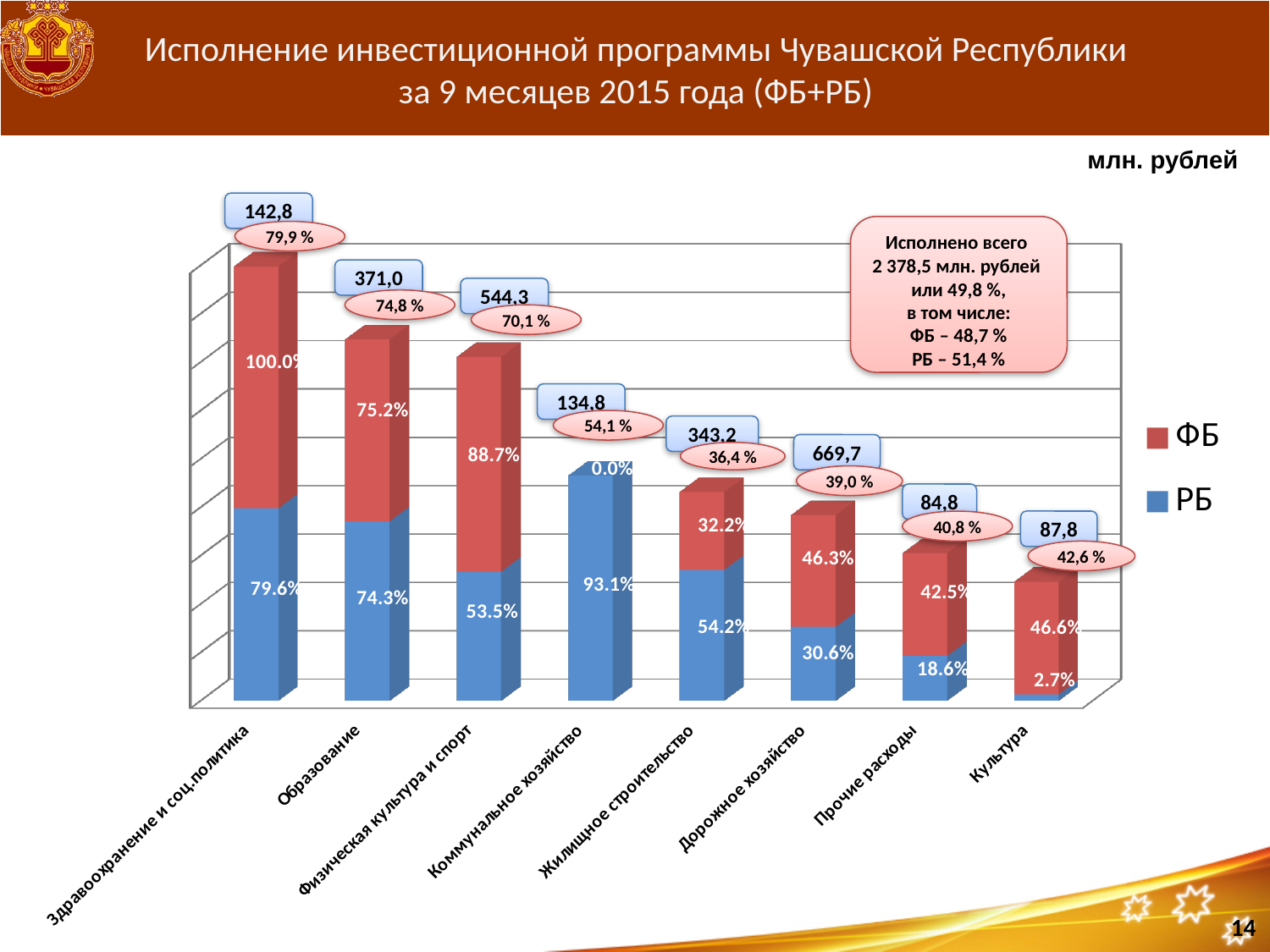
Which category has the lowest amount in млн. рублей shown in its callout? Прочие расходы What is the ФБ value labelled for Коммунальное хозяйство? 0.0% How many series does the legend list? 2 What is the РБ value labelled for Коммунальное хозяйство? 93.1% What kind of chart is shown on the slide? bar chart What amount in млн. рублей is shown in the callout above Дорожное хозяйство? 669,7 What percentage is shown in the oval callout above Образование? 74,8 % What is the ФБ value labelled for Здравоохранение и соц.политика? 100.0% How many categories are shown along the x axis? 8 Which category has the highest amount in млн. рублей shown in its callout? Дорожное хозяйство Which has the larger ФБ label, Образование or Жилищное строительство? Образование What is the РБ value labelled for Культура? 2.7%